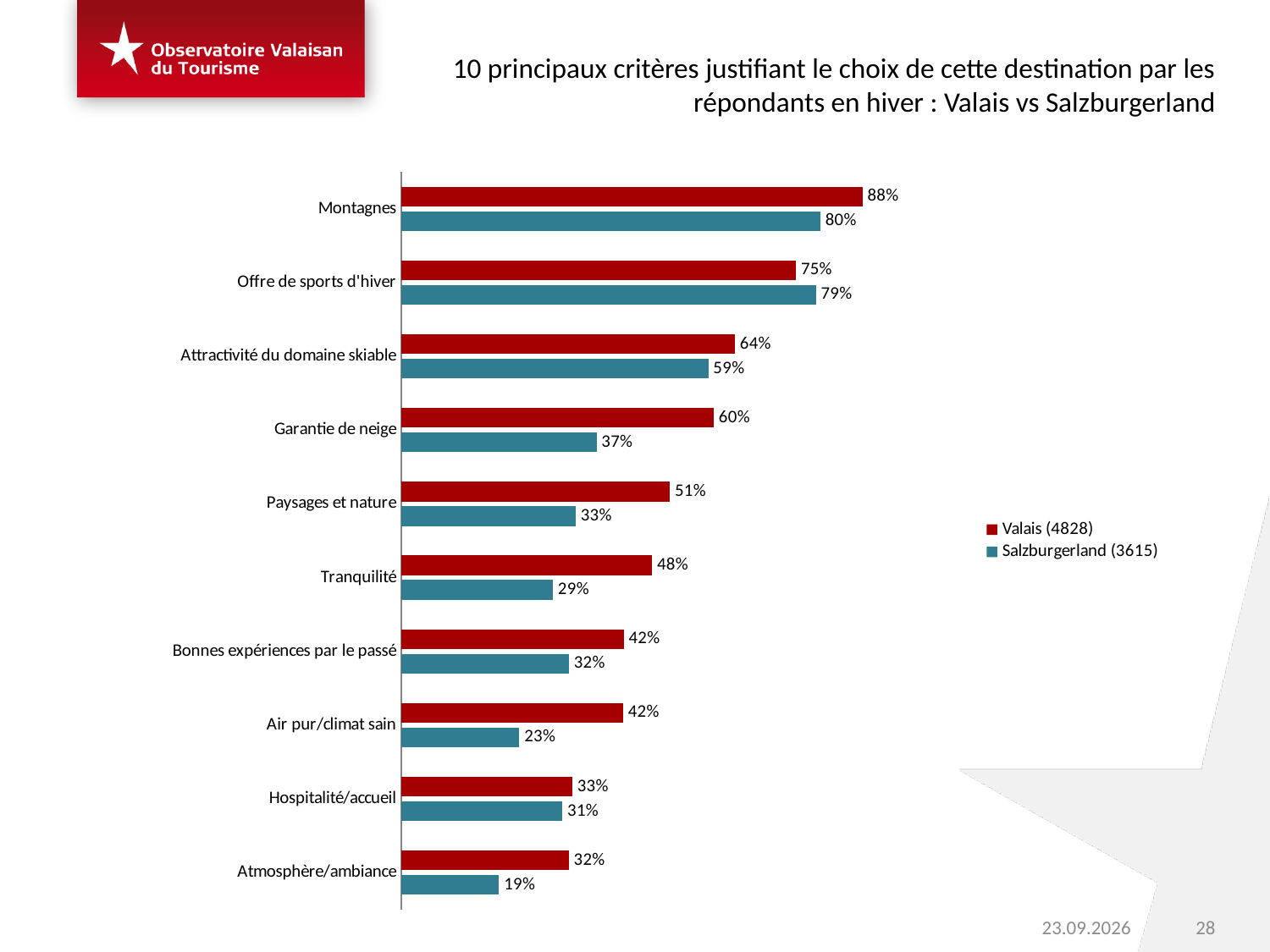
For Offre de sports d'hiver, which series has the larger value, Valais (4828) or Salzburgerland (3615)? Salzburgerland (3615) How many series does the legend list? 2 What kind of chart is shown on the slide? Bar chart What is the difference between the Valais (4828) and Salzburgerland (3615) values for Air pur/climat sain? 19% Which category has the lowest value for Salzburgerland (3615)? Atmosphère/ambiance What is the difference between the Valais (4828) values for Montagnes and Atmosphère/ambiance? 56% What is the value for Salzburgerland (3615) for Atmosphère/ambiance? 19% Which colour represents Valais (4828) in the chart? Red How many categories are shown in the chart? 10 What is the value for Salzburgerland (3615) for Garantie de neige? 37% What is the value for Valais (4828) for Montagnes? 88% Which category has the highest value for Valais (4828)? Montagnes